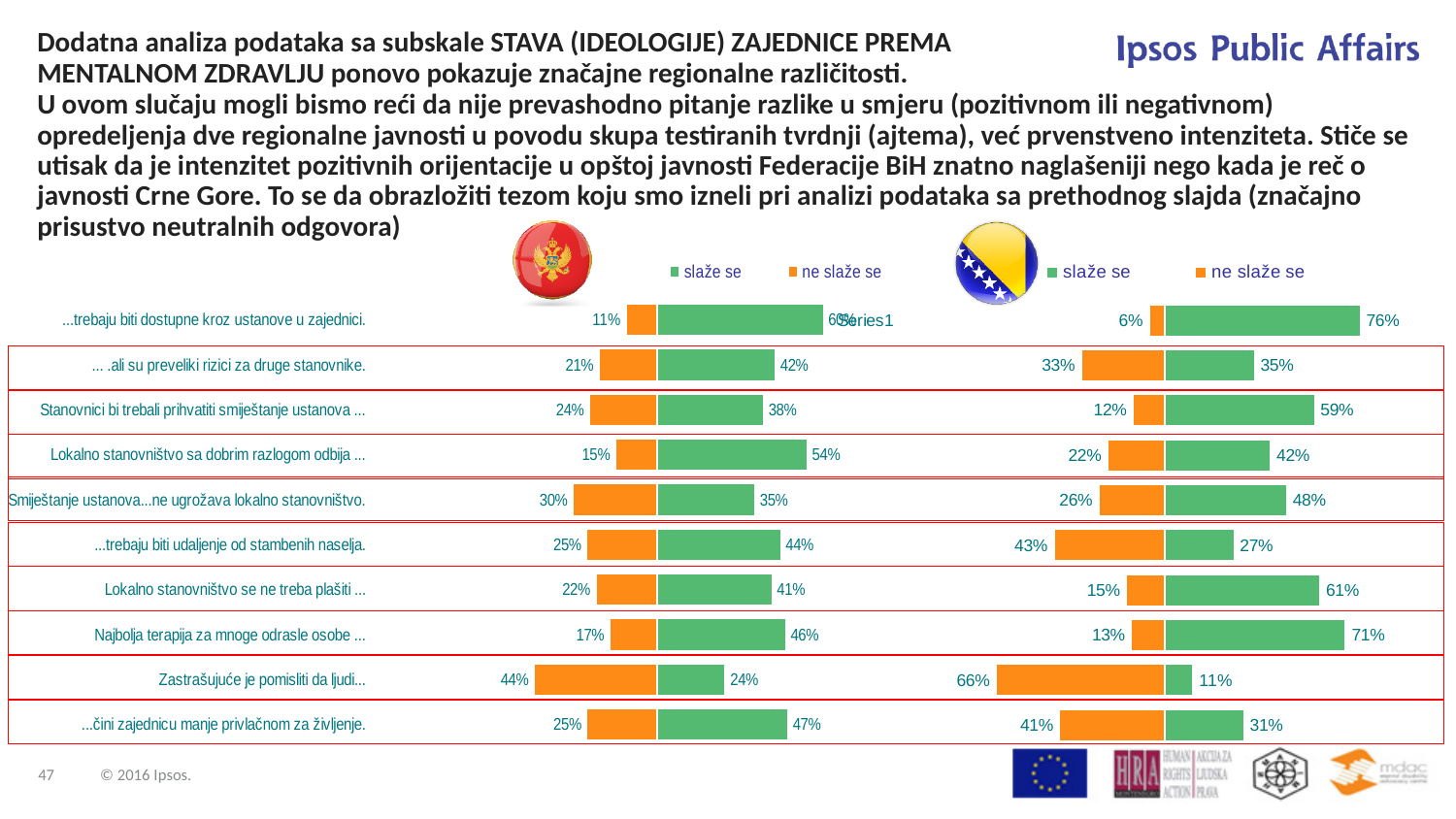
How many statements (categories) are shown in the left chart? 10 In the right chart, what is the 'slaže se' value for '...trebaju biti dostupne kroz ustanove u zajednici.'? 76% In the right chart, which statement has the highest 'ne slaže se' value? Zastrašujuće je pomisliti da ljudi... In the right chart, what is the 'ne slaže se' value for '...trebaju biti udaljenje od stambenih naselja.'? 43% In the left chart, what is the 'slaže se' value for 'Lokalno stanovništvo sa dobrim razlogom odbija ...'? 54% In the left chart, what percentage of respondents 'ne slaže se' with 'Zastrašujuće je pomisliti da ljudi...'? 44% How many series does the legend of the right chart list? 2 In the left chart, which is larger for 'Smiještanje ustanova...ne ugrožava lokalno stanovništvo.': 'slaže se' or 'ne slaže se'? slaže se In the right chart, what is the difference between the 'slaže se' and 'ne slaže se' values for 'Najbolja terapija za mnoge odrasle osobe ...'? 58% In the left chart, which statement has the lowest 'slaže se' value? Zastrašujuće je pomisliti da ljudi... In the right chart, what is the total of 'slaže se' and 'ne slaže se' for 'Lokalno stanovništvo se ne treba plašiti ...'? 76% What type of chart is the left chart? bar chart